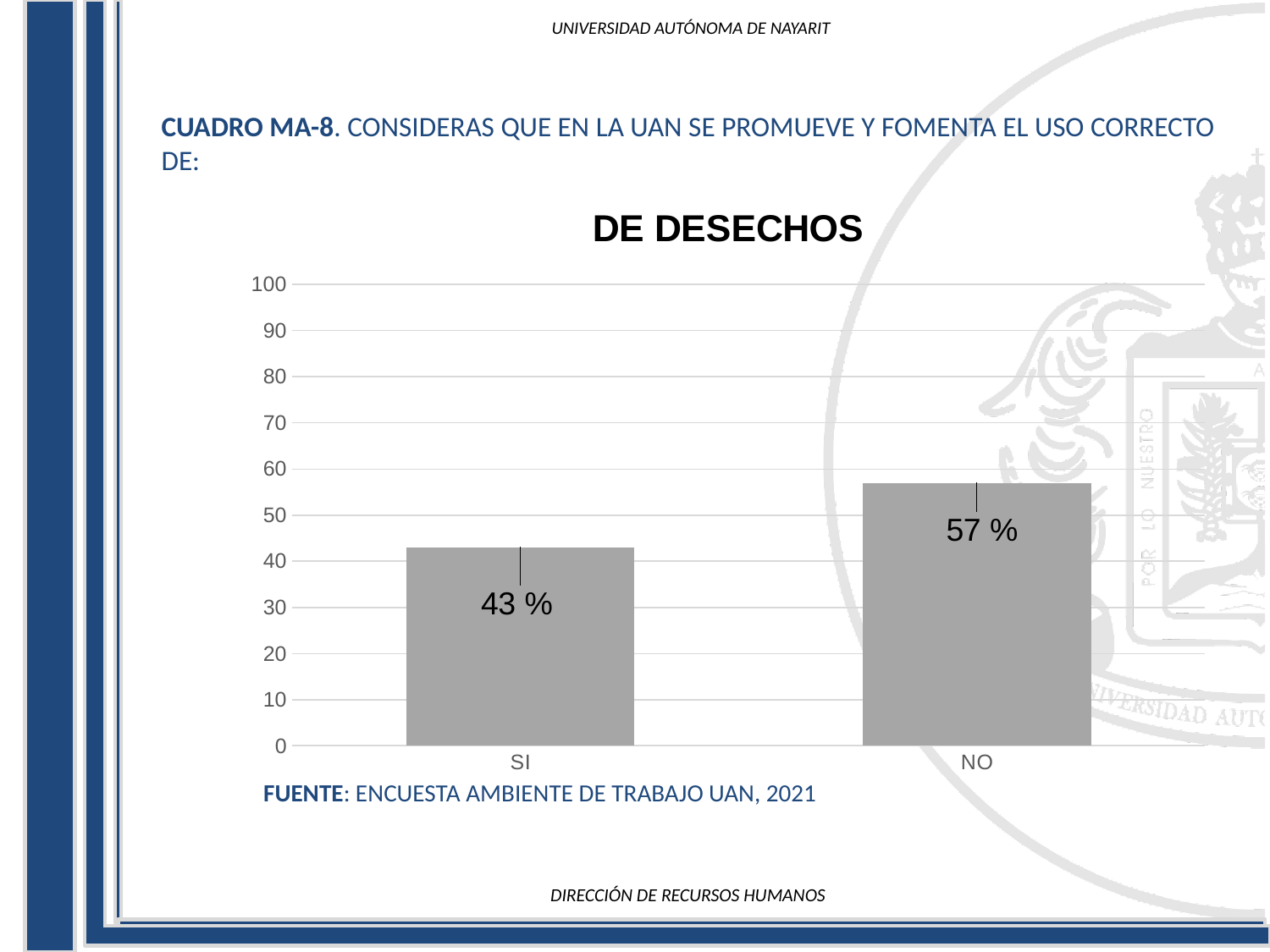
How many categories are shown on the x axis? 2 Which category has the highest value? NO Is the value for NO greater or less than 50? greater Is the value for SI greater or less than 50? less Which category has the lowest value? SI Which is larger, the value for SI or the value for NO? NO What is the value for SI? 43 % What is the title of the chart? DE DESECHOS What kind of chart is shown on the slide? bar chart What is the maximum value shown on the y axis? 100 What is the value for NO? 57 % What is the difference between the values for NO and SI? 14 %